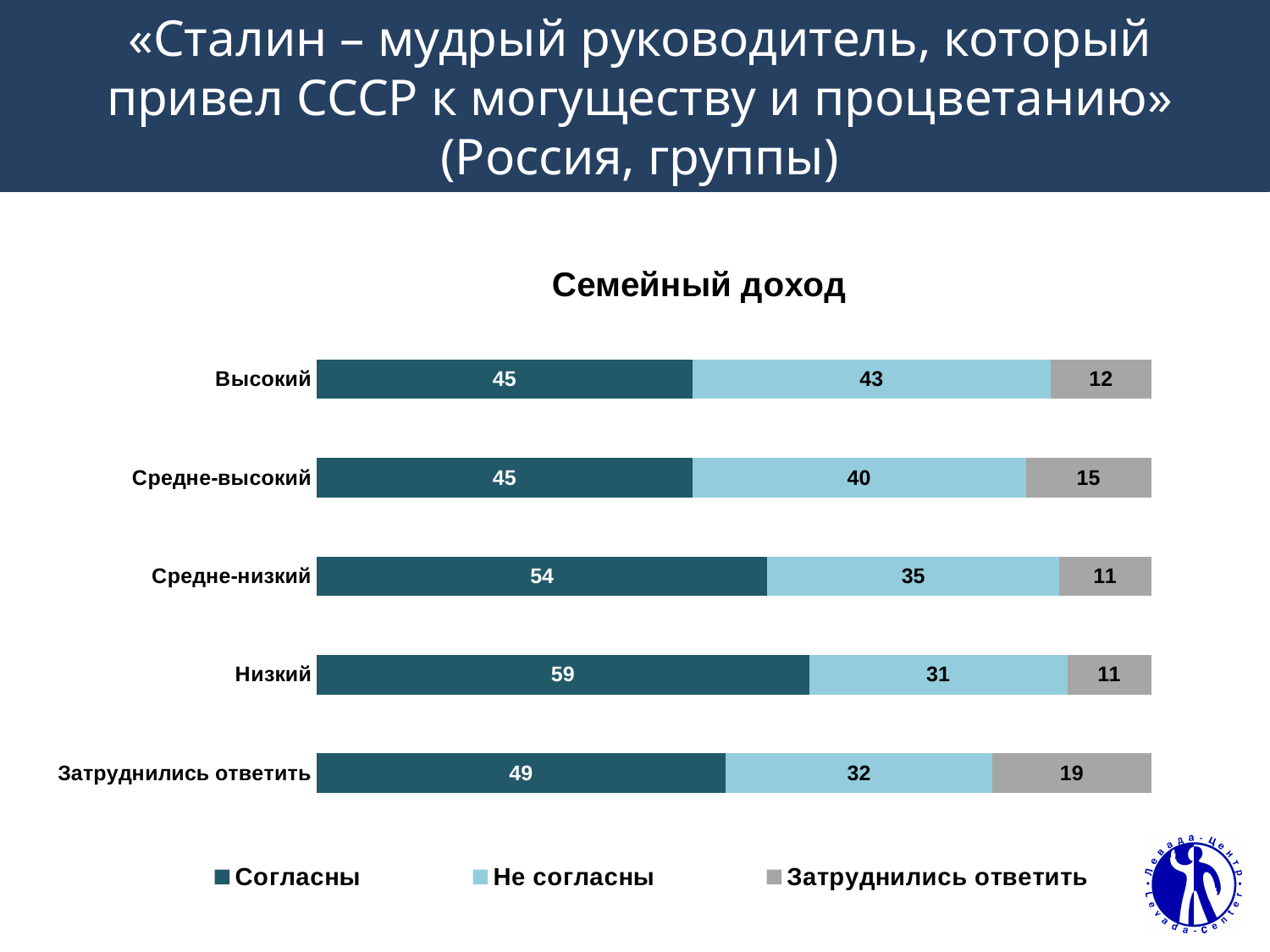
Which category has the lowest value for "Не согласны"? Низкий Which category has the highest value for "Согласны"? Низкий What is the title of the chart? Семейный доход What kind of chart is shown on the slide? Stacked bar chart What is the difference between the "Согласны" values for "Низкий" and "Высокий"? 14 What is the value for "Не согласны" in the "Высокий" category? 43 Which is larger: the "Не согласны" value for "Средне-высокий" or for "Средне-низкий"? Средне-высокий What is the value for "Затруднились ответить" in the "Средне-высокий" category? 15 How many series does the legend list? 3 What is the total of the stacked bar for "Затруднились ответить" (the category)? 100 How many categories are shown on the chart? 5 What is the value for "Согласны" in the "Низкий" category? 59